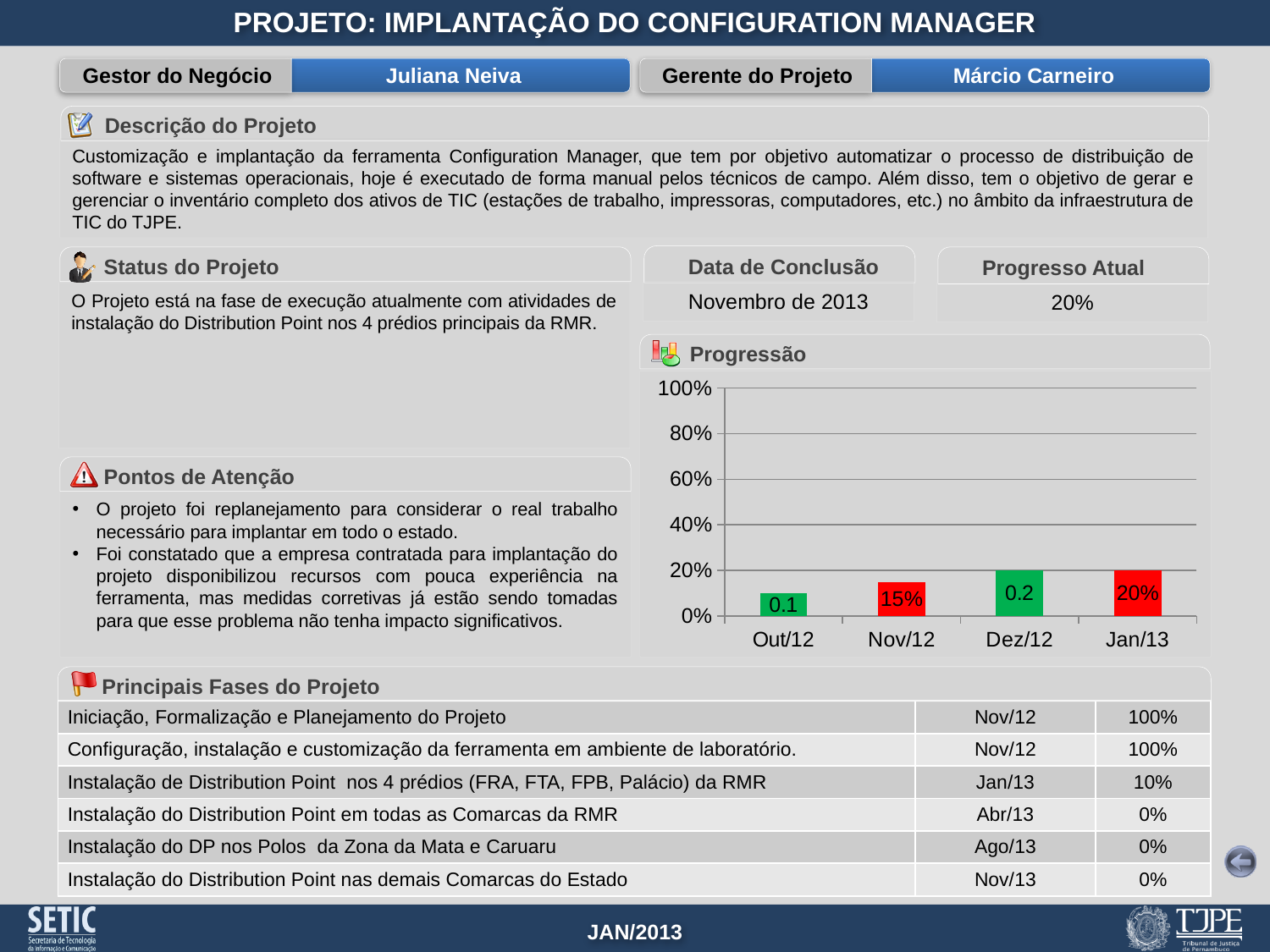
What value is shown for Jan/13 in the Progressão chart? 20% What colour is the Nov/12 bar in the Progressão chart? red Which month has the lowest bar in the Progressão chart? Out/12 Do the values in the Progressão chart generally rise or fall from Out/12 to Jan/13? rise Is the value for Out/12 in the Progressão chart greater or less than 20%? less How many months are plotted on the x axis of the Progressão chart? 4 What kind of chart is the Progressão chart? bar chart What is the difference between the Jan/13 and Nov/12 values in the Progressão chart? 5% What is the data label on the Dez/12 bar in the Progressão chart? 0.2 What value is shown for Nov/12 in the Progressão chart? 15% In the Progressão chart, which is larger: the value for Nov/12 or the value for Out/12? Nov/12 What is the data label shown on the Out/12 bar in the Progressão chart? 0.1